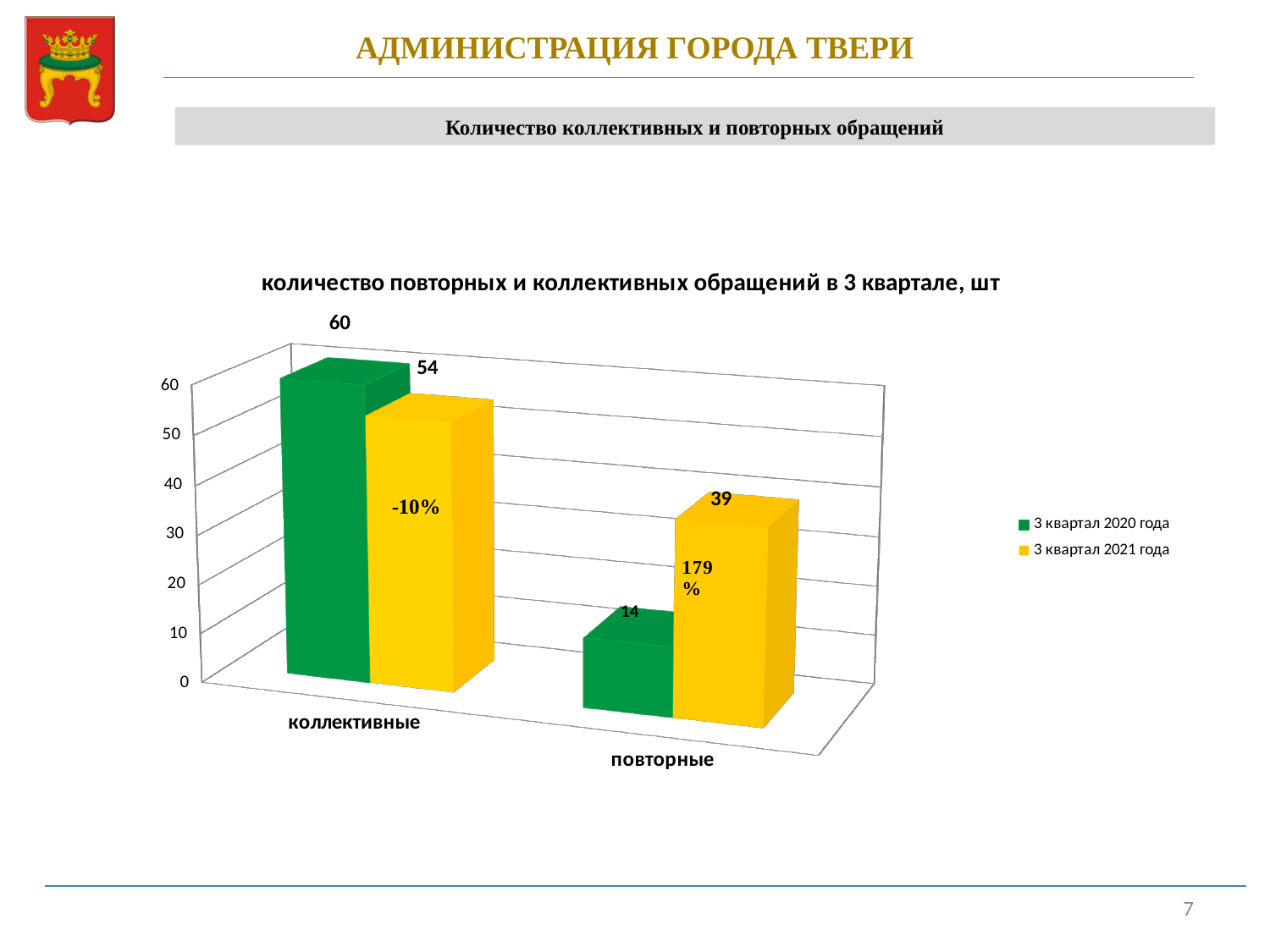
What is the title of the chart? количество повторных и коллективных обращений в 3 квартале, шт What is the value for коллективные in 3 квартал 2021 года? 54 How many categories are shown on the x axis? 2 How many series does the legend list? 2 Which category has the lowest value in 3 квартал 2021 года? повторные Which is larger for коллективные: the 3 квартал 2020 года value or the 3 квартал 2021 года value? 3 квартал 2020 года What kind of chart is shown on the slide? bar chart What is the value for повторные in 3 квартал 2020 года? 14 What is the value for коллективные in 3 квартал 2020 года? 60 Which category has the highest value in 3 квартал 2020 года? коллективные What is the value for повторные in 3 квартал 2021 года? 39 What is the difference between the 3 квартал 2020 года and 3 квартал 2021 года values for повторные? 25